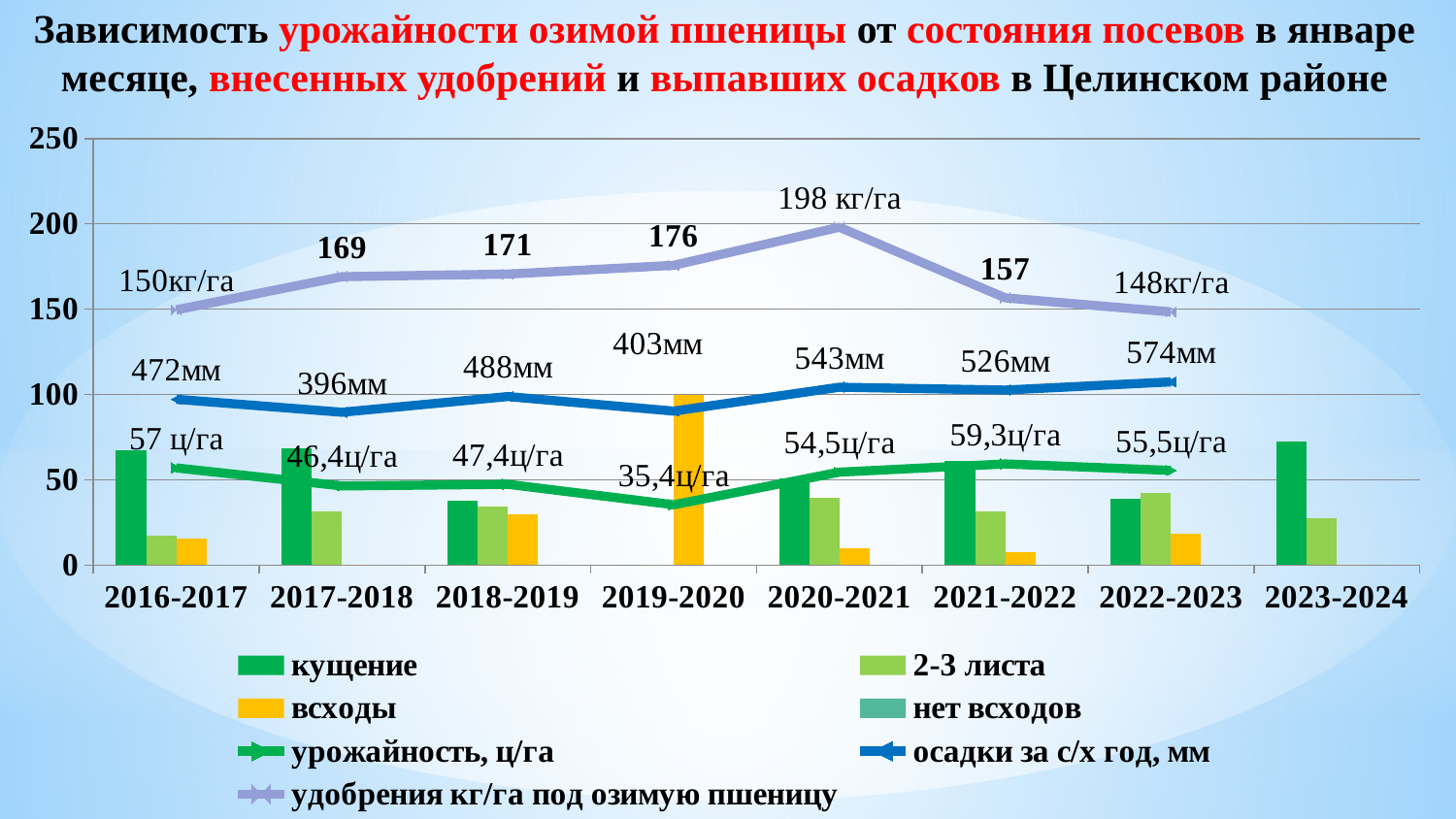
In which season is the осадки (precipitation) value lowest? 2017-2018 Is the кущение bar for 2023-2024 greater or less than 50? greater What is the value of удобрения (fertilizer) for 2020-2021? 198 кг/га What is the урожайность (yield) value for 2021-2022? 59,3ц/га In which season is the урожайность (yield) lowest? 2019-2020 What is the осадки (precipitation) value for 2022-2023? 574мм What kind of chart is shown on the slide? Combined bar and line chart In which season is the удобрения (fertilizer) value highest? 2020-2021 Which season has the higher урожайность: 2016-2017 or 2021-2022? 2021-2022 How many seasons are shown on the x axis? 8 How many series does the legend list? 7 What is the difference between the удобрения values for 2020-2021 and 2021-2022? 41 кг/га